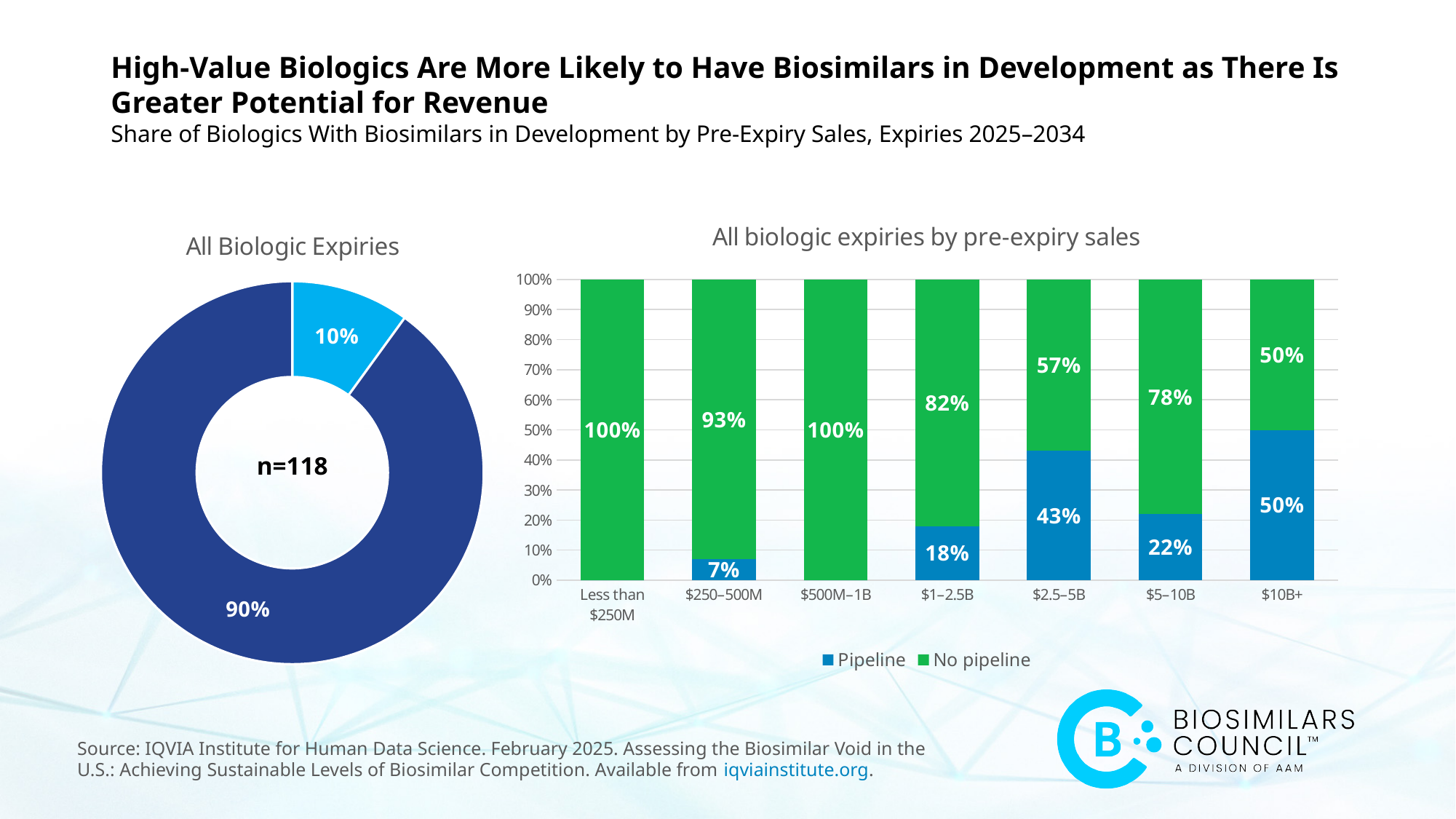
In the 'All biologic expiries by pre-expiry sales' chart, what is the Pipeline value for the $250–500M category? 7% In the 'All biologic expiries by pre-expiry sales' chart, which category has the lowest No pipeline share? $10B+ What kind of chart is the 'All Biologic Expiries' chart on the left? Donut (pie) chart In the 'All biologic expiries by pre-expiry sales' chart, what is the difference between the Pipeline values for $5–10B and $1–2.5B? 4% How many series does the legend of the 'All biologic expiries by pre-expiry sales' chart list? 2 In the 'All biologic expiries by pre-expiry sales' chart, what is the No pipeline value for the $1–2.5B category? 82% In the 'All biologic expiries by pre-expiry sales' chart, which is larger: the Pipeline value for $2.5–5B or for $5–10B? $2.5–5B What sample size is shown in the centre of the 'All Biologic Expiries' donut chart? n=118 In the 'All biologic expiries by pre-expiry sales' chart, what is the Pipeline value for the $2.5–5B category? 43% In the 'All Biologic Expiries' chart, what share does the light blue slice represent? 10% In the 'All biologic expiries by pre-expiry sales' chart, which category has the highest Pipeline share? $10B+ How many categories are shown on the x axis of the 'All biologic expiries by pre-expiry sales' chart? 7